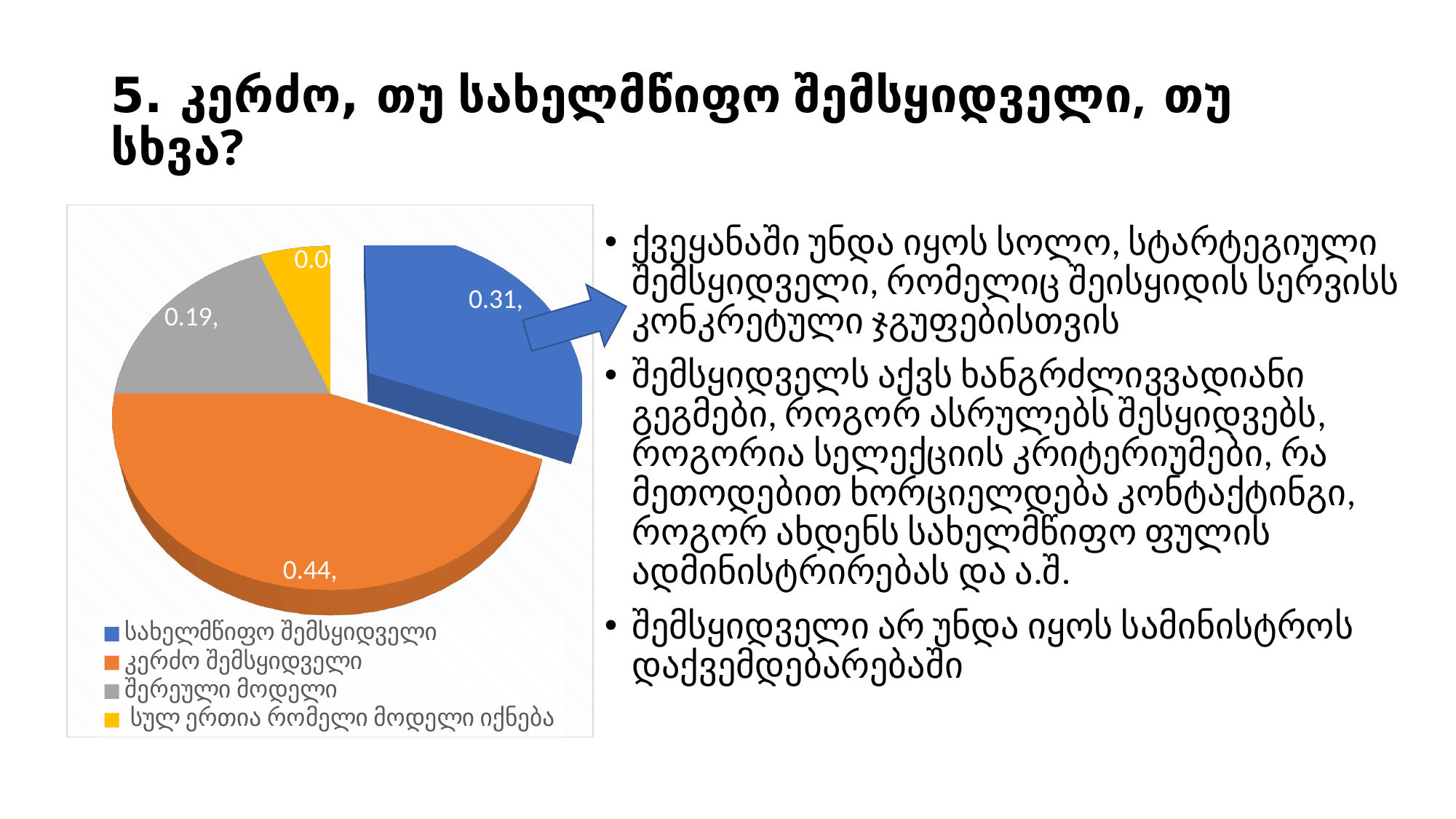
What is the difference between the values for კერძო შემსყიდველი and სახელმწიფო შემსყიდველი? 0.13 How many slices does the pie chart have? 4 Which category has the smallest slice of the pie? სულ ერთია რომელი მოდელი იქნება What is the value shown for კერძო შემსყიდველი? 0.44 What kind of chart is shown on the slide? pie chart What is the value shown for შერეული მოდელი? 0.19 What is the value shown for სახელმწიფო შემსყიდველი? 0.31 Which colour represents შერეული მოდელი in the pie chart? gray What is the difference between the values for სახელმწიფო შემსყიდველი and შერეული მოდელი? 0.12 Which category is shown in blue in the pie chart? სახელმწიფო შემსყიდველი Which is larger, the value for შერეული მოდელი or the value for სახელმწიფო შემსყიდველი? სახელმწიფო შემსყიდველი Which category has the largest slice of the pie? კერძო შემსყიდველი